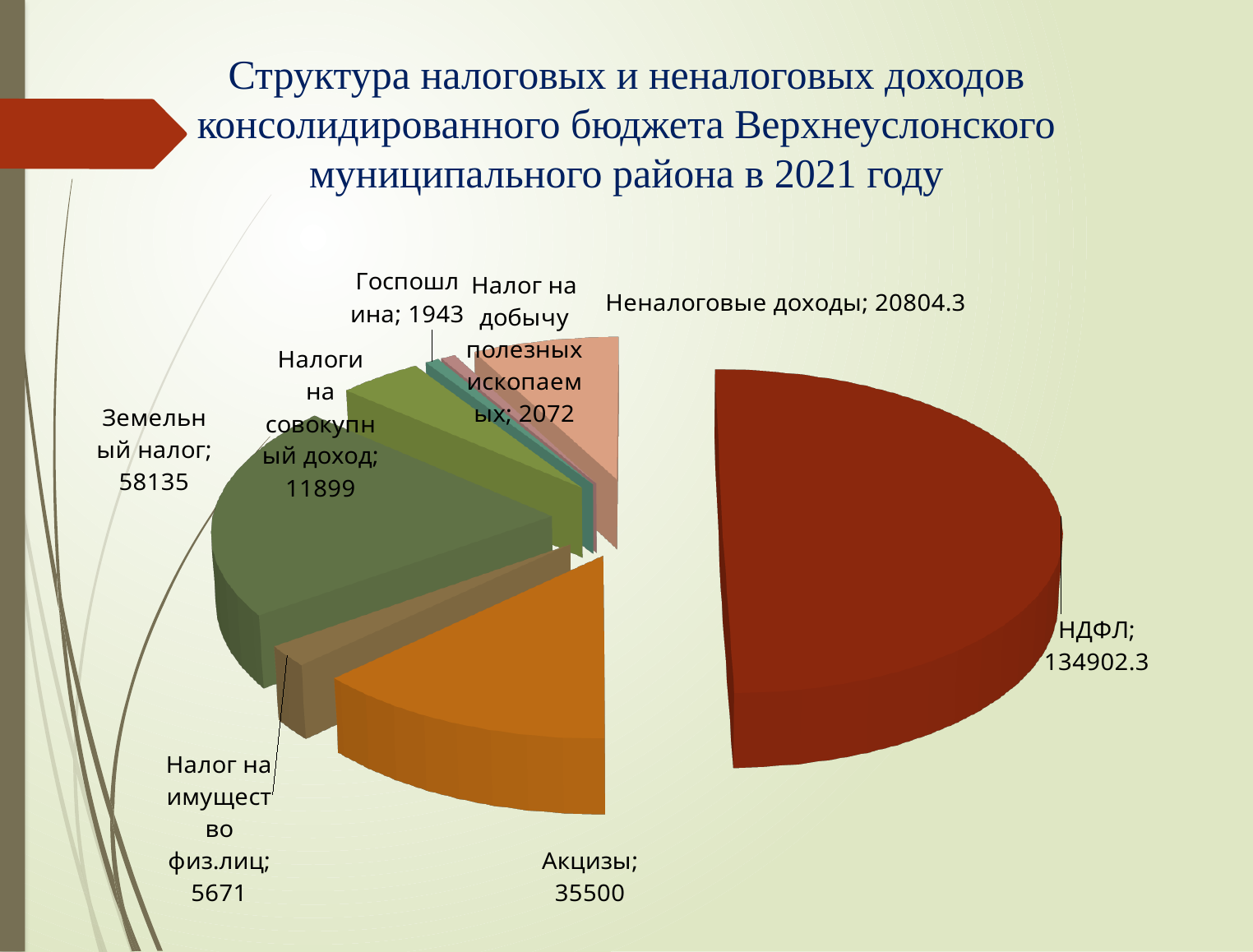
What is the value shown for Акцизы? 35500 What is the difference between the values for Земельный налог and Акцизы? 22635 Which category has the smallest value in the chart? Госпошлина What is the value shown for НДФЛ? 134902.3 Which is larger: Налоги на совокупный доход or Налог на добычу полезных ископаемых? Налоги на совокупный доход What is the value shown for Земельный налог? 58135 What kind of chart is shown on the slide? Pie chart What is the value shown for Неналоговые доходы? 20804.3 What is the value shown for Налог на имущество физ.лиц? 5671 How many slices does the pie chart have? 8 What is the difference between the values for НДФЛ and Неналоговые доходы? 114098 Which category has the largest slice of the pie? НДФЛ